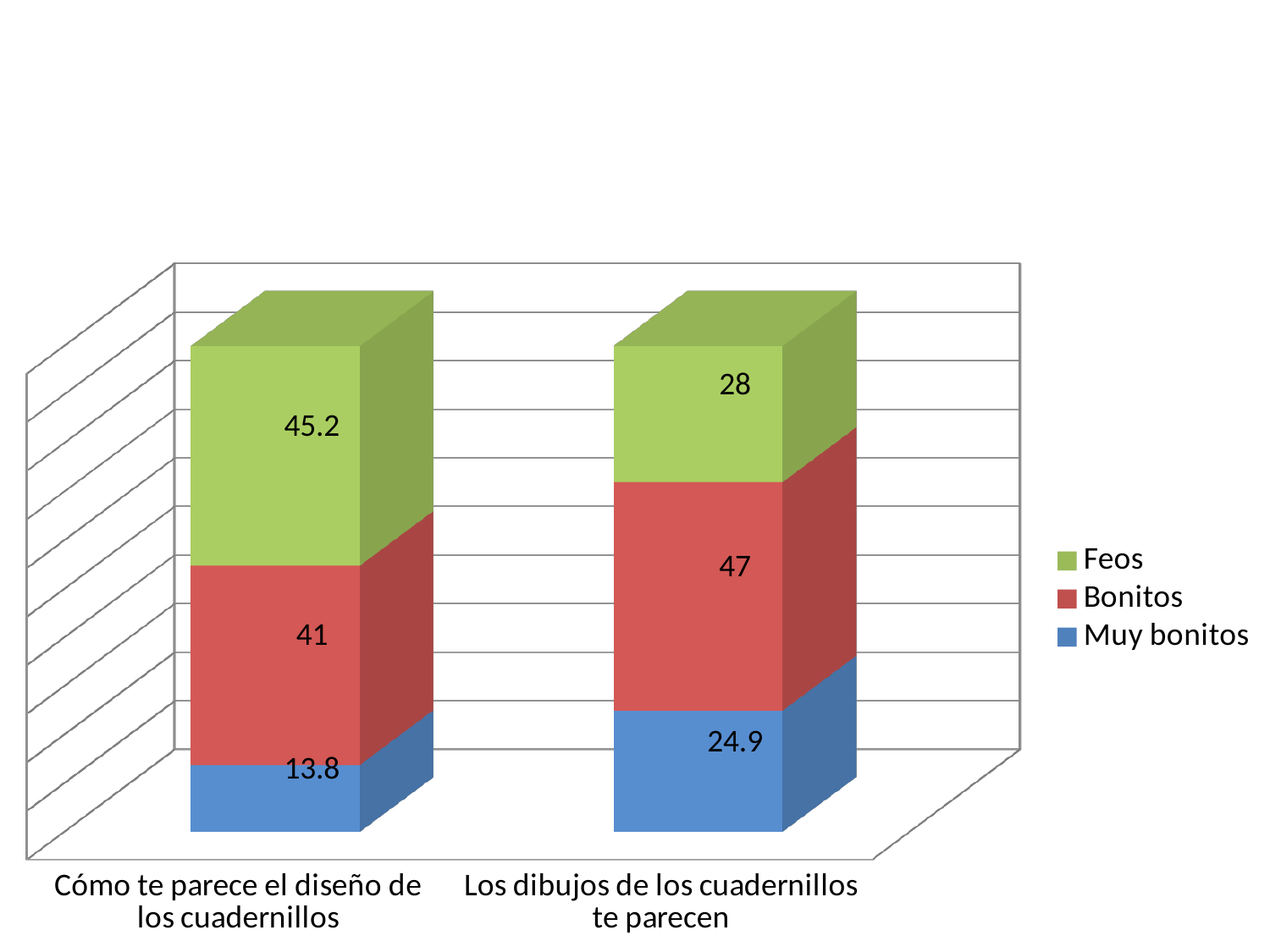
How many series does the legend list? 3 What is the difference between the Feos values for the two categories? 17.2 What is the value for Muy bonitos in the category "Los dibujos de los cuadernillos te parecen"? 24.9 What is the value for Bonitos in the category "Cómo te parece el diseño de los cuadernillos"? 41 What is the value for Feos in the category "Los dibujos de los cuadernillos te parecen"? 28 How many categories are shown on the x axis? 2 What is the value for Feos in the category "Cómo te parece el diseño de los cuadernillos"? 45.2 Which series has the lowest value in the category "Cómo te parece el diseño de los cuadernillos"? Muy bonitos What is the total of the stacked bar for "Cómo te parece el diseño de los cuadernillos"? 100 Which series has the highest value in the category "Los dibujos de los cuadernillos te parecen"? Bonitos Which is larger: Muy bonitos for "Cómo te parece el diseño de los cuadernillos" or Muy bonitos for "Los dibujos de los cuadernillos te parecen"? Los dibujos de los cuadernillos te parecen What kind of chart is shown on the slide? Stacked bar chart